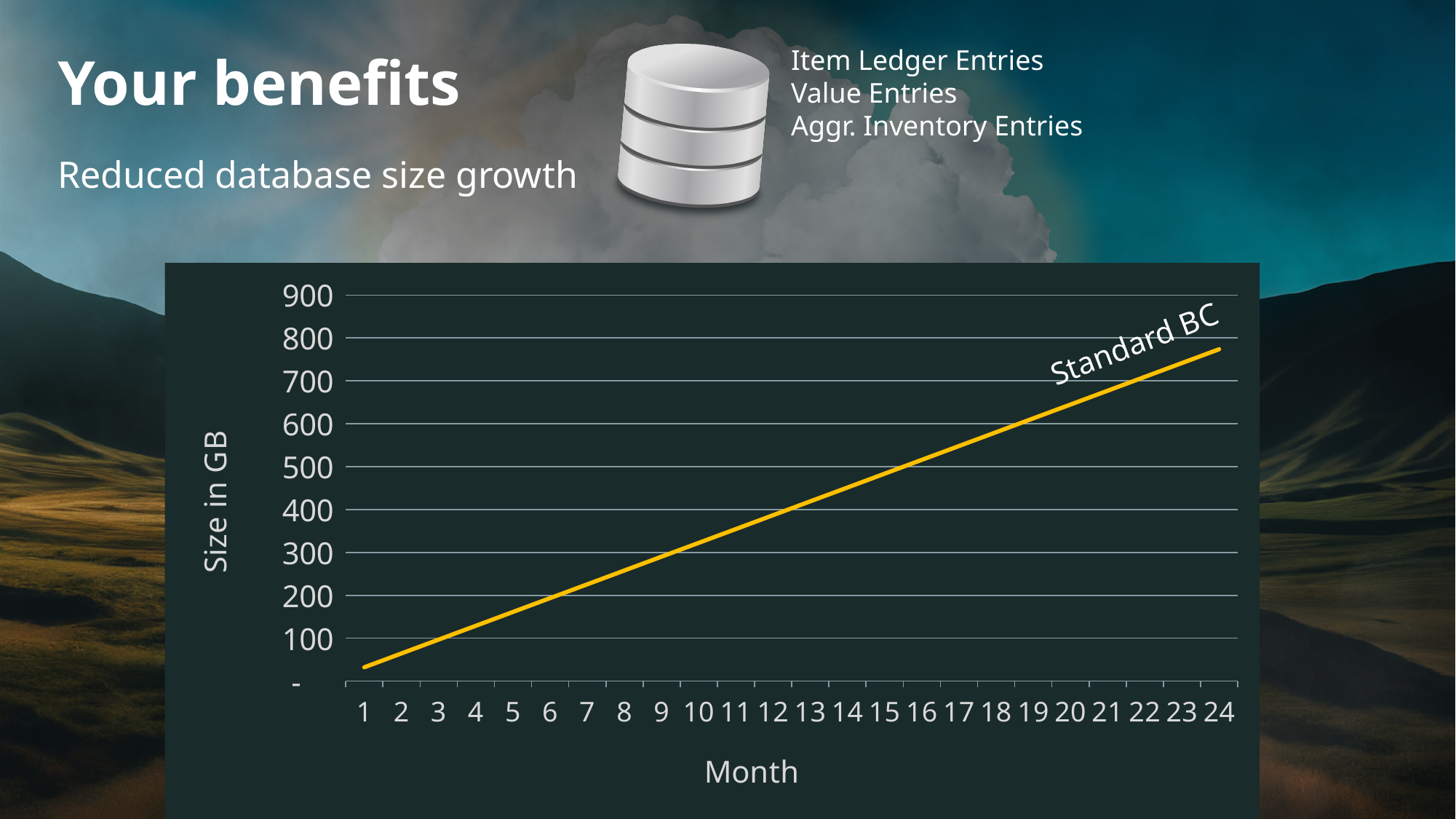
Is the value for Standard BC at month 12 greater or less than 300? greater What is the label of the line plotted in the chart? Standard BC Which month has the highest value for Standard BC? 24 What kind of chart is shown on the slide? line chart What is the y-axis title of the chart? Size in GB Does the Standard BC line rise or fall as the month increases? rise Is the value for Standard BC at month 24 greater or less than 700? greater Is the value for Standard BC at month 6 greater or less than 300? less Which month has the lowest value for Standard BC? 1 How many months are shown on the x axis of the chart? 24